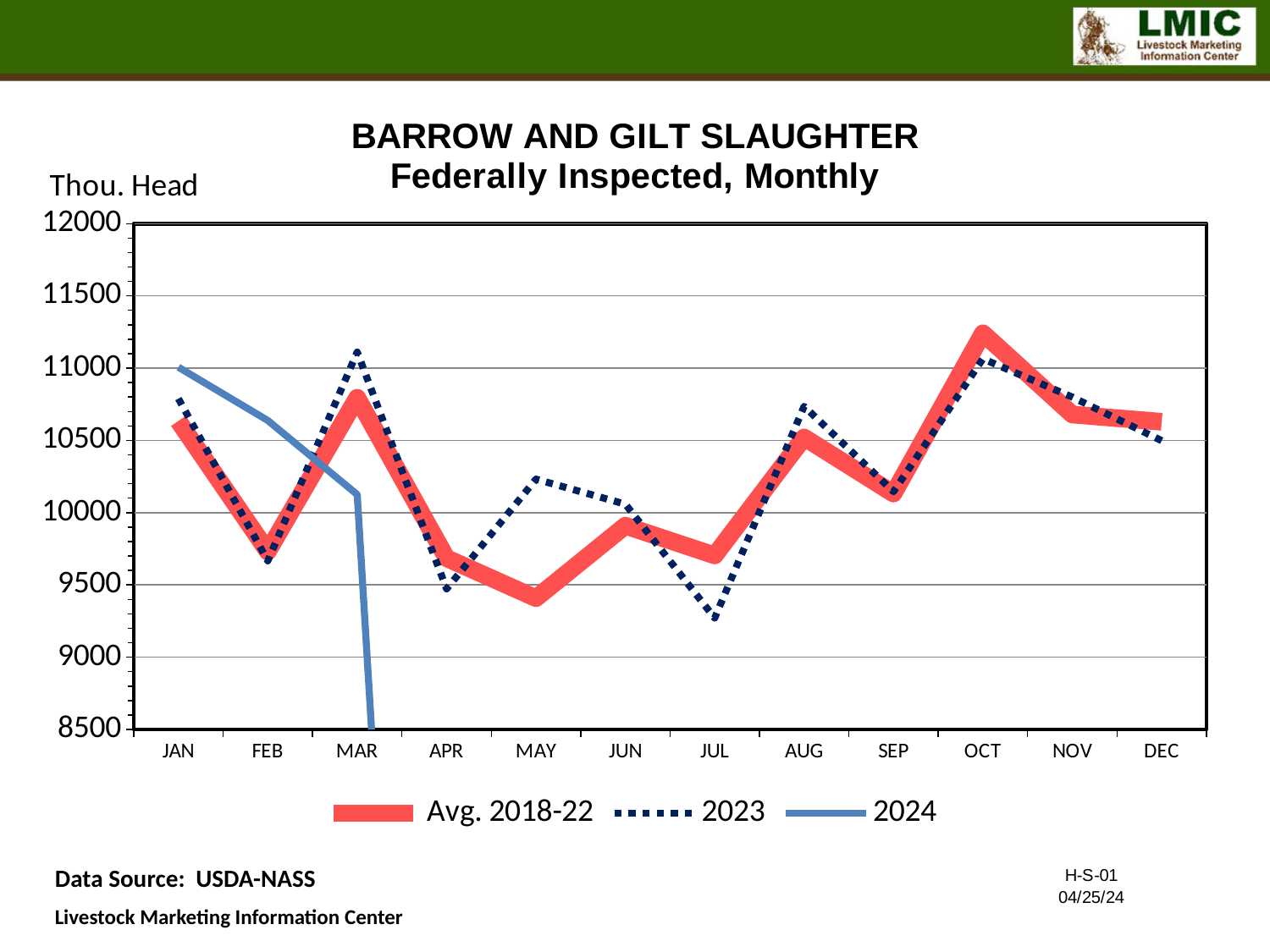
How many months are shown along the x axis? 12 Is the 2023 value for JUL greater or less than 9500? less Is the 2024 value for FEB greater or less than 10500? greater In JAN, which series is higher: 2024 or 2023? 2024 Is the Avg. 2018-22 value for OCT greater or less than 11000? greater In which month is the Avg. 2018-22 series highest? OCT In which month is the Avg. 2018-22 series lowest? MAY What kind of chart is shown on the slide? line chart What is the unit label shown on the y axis? Thou. Head In MAY, which series is higher: 2023 or Avg. 2018-22? 2023 In which month is the 2023 series lowest? JUL How many series does the legend list? 3